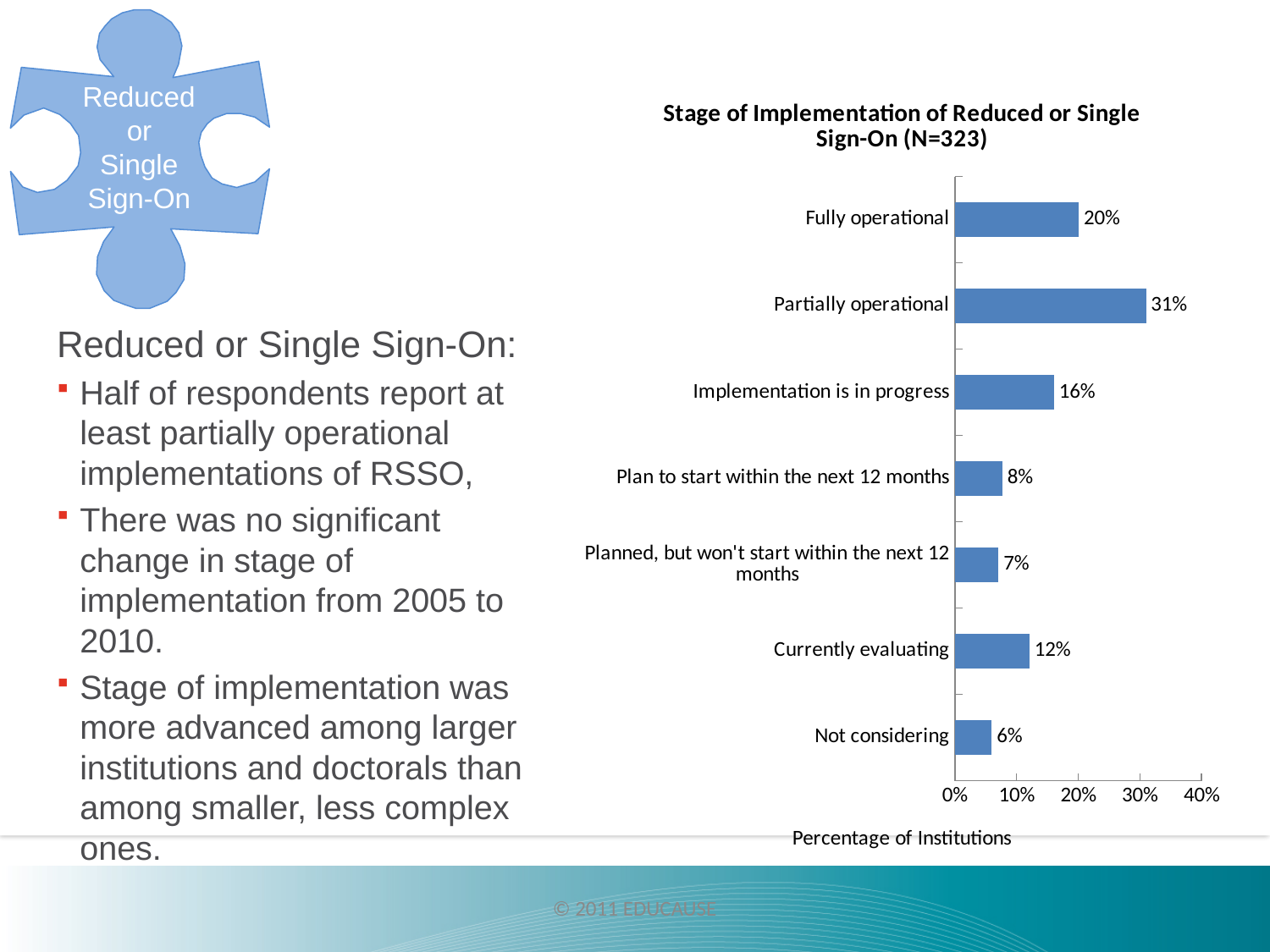
What percentage of institutions report being fully operational? 20% What kind of chart is shown on the slide? Bar chart What is the value for 'Partially operational'? 31% What is the difference between 'Partially operational' and 'Fully operational'? 11% Which stage of implementation has the lowest percentage of institutions? Not considering What is the value for 'Not considering'? 6% What is the title of the chart? Stage of Implementation of Reduced or Single Sign-On (N=323) What percentage of institutions are currently evaluating? 12% Which is larger: 'Implementation is in progress' or 'Currently evaluating'? Implementation is in progress How many stages of implementation are shown in the chart? 7 Is the value for 'Plan to start within the next 12 months' greater or less than 10%? less Which stage of implementation has the highest percentage of institutions? Partially operational